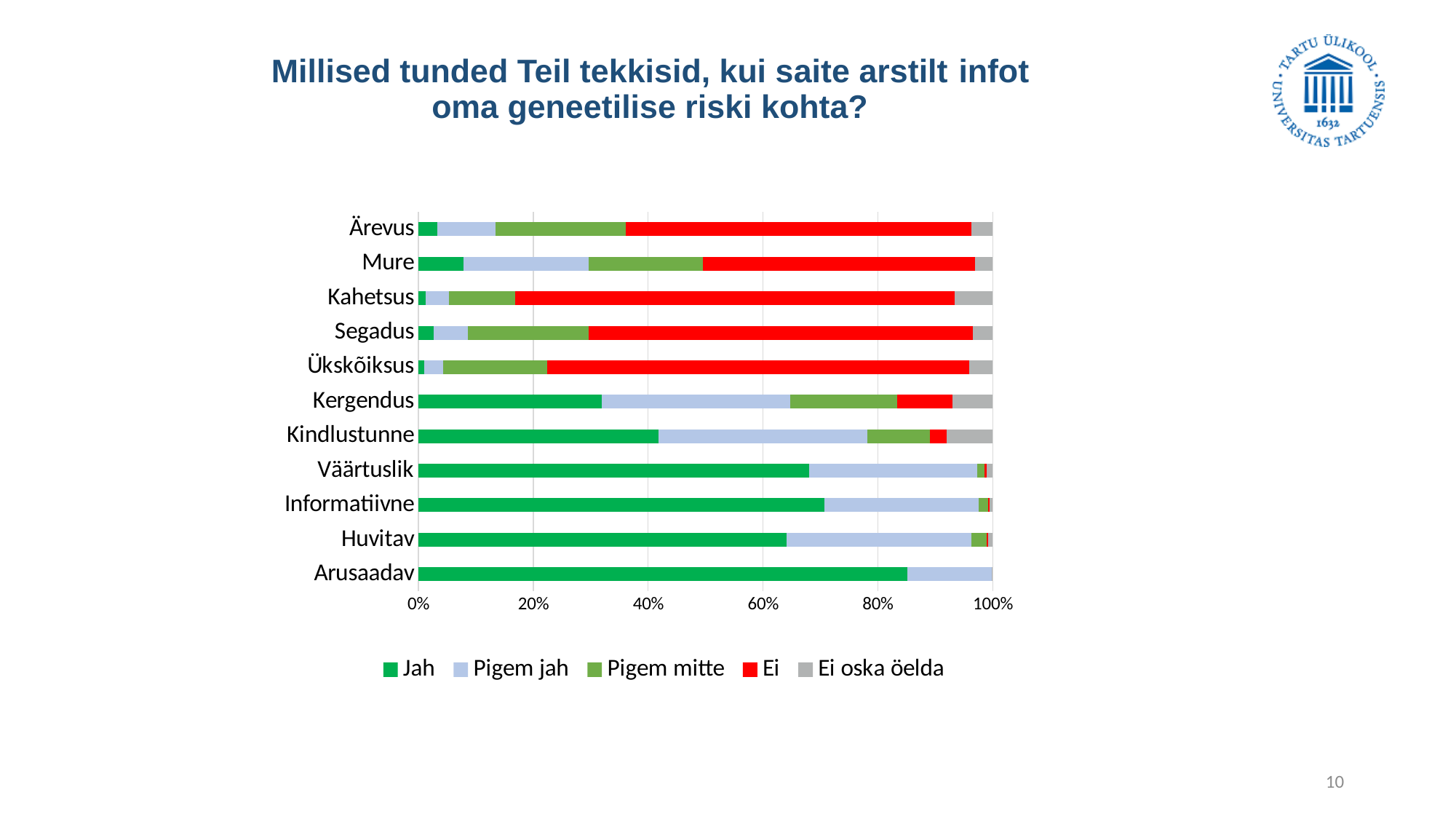
Is the 'Jah' share for Arusaadav greater or less than 80%? greater Which has the larger 'Ei' share, Ärevus or Kergendus? Ärevus Which has the larger 'Jah' share, Kindlustunne or Kergendus? Kindlustunne How many series does the chart legend list? 5 Which category has the largest 'Jah' share? Arusaadav How many categories (feelings) are listed on the vertical axis of the chart? 11 Is the 'Jah' share for Kergendus greater or less than 40%? less What is the last entry in the chart legend? Ei oska öelda What kind of chart is shown on the slide? Stacked bar chart Which has the larger 'Jah' share, Mure or Ärevus? Mure What colour represents the 'Ei' series in the chart? Red Is the 'Jah' share for Informatiivne greater or less than 60%? greater